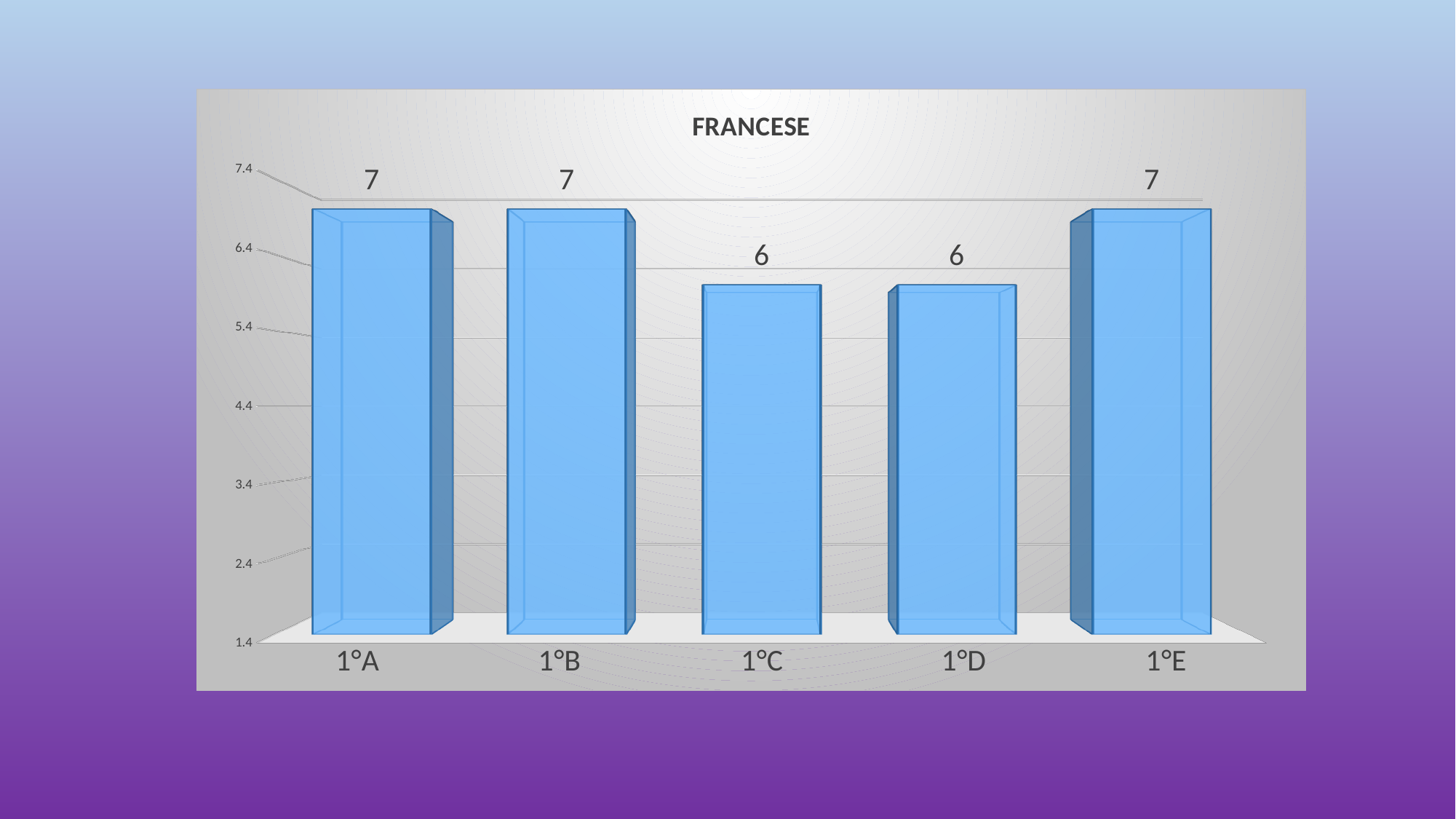
What is the title of the chart? FRANCESE What is the difference between the values for 1°B and 1°C? 1 What kind of chart is this? bar chart Which categories have the lowest value? 1°C and 1°D Which is larger, the value for 1°A or the value for 1°D? 1°A How many categories are shown on the x axis? 5 What is the value for 1°E? 7 What colour are the bars? blue What is the value for 1°D? 6 What is the value for 1°A? 7 What is the value for 1°C? 6 Is the value for 1°C greater or less than 5.4? greater